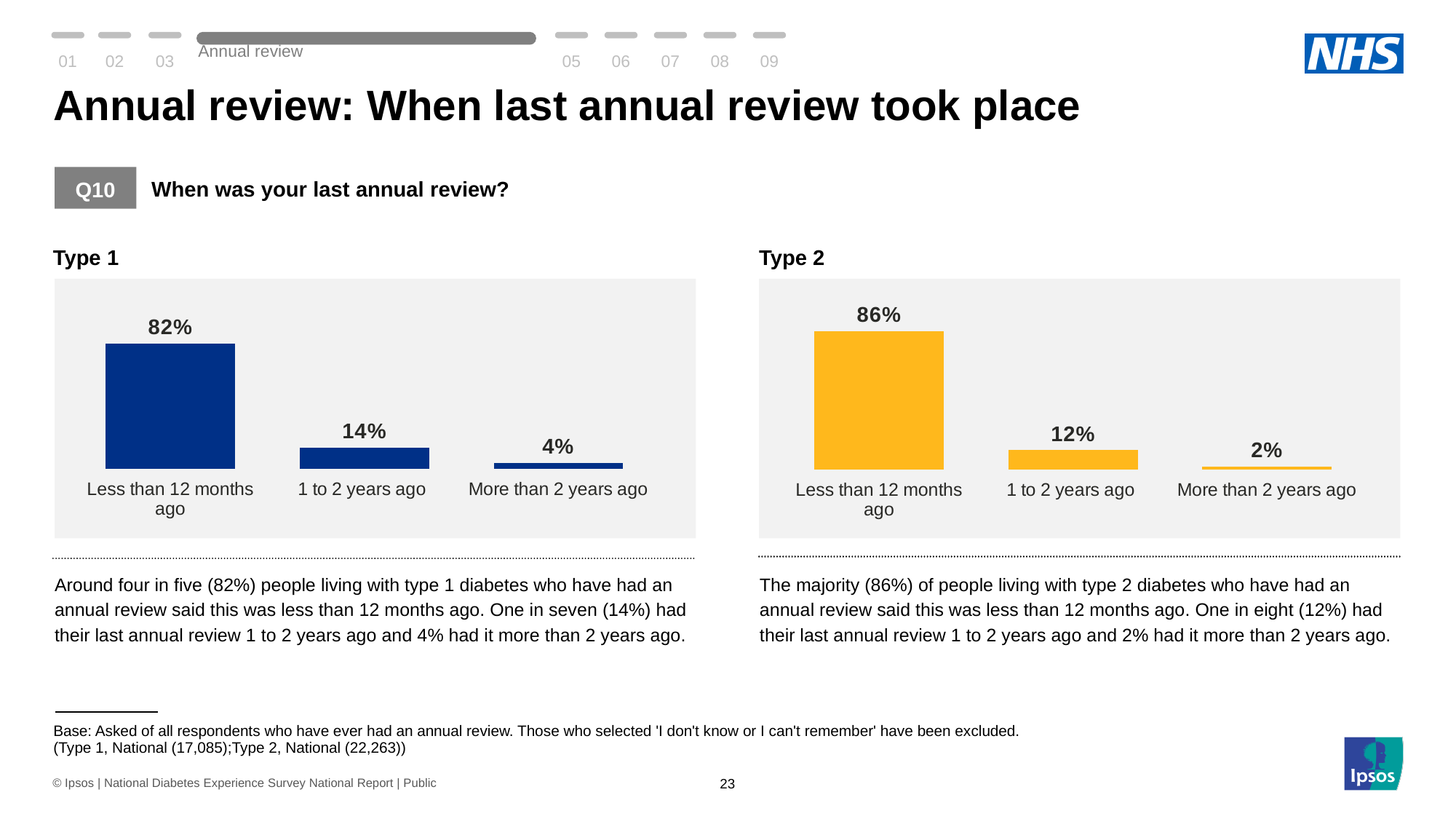
In the Type 1 chart, what is the difference between 'Less than 12 months ago' and '1 to 2 years ago'? 68 percentage points How many categories are shown in the Type 2 chart? 3 In the Type 2 chart, do the values rise or fall from left to right? Fall What kind of chart is the Type 1 chart? Bar chart What colour are the bars in the Type 2 chart? Yellow Which is larger: the 'Less than 12 months ago' value in the Type 1 chart or in the Type 2 chart? Type 2 In the Type 1 chart, what percentage had their last annual review less than 12 months ago? 82% In the Type 1 chart, which category has the lowest value? More than 2 years ago In the Type 2 chart, what is the difference between '1 to 2 years ago' and 'More than 2 years ago'? 10 percentage points In the Type 2 chart, which category has the highest value? Less than 12 months ago In the Type 1 chart, what is the value for 'More than 2 years ago'? 4% In the Type 2 chart, what percentage had their last annual review 1 to 2 years ago? 12%